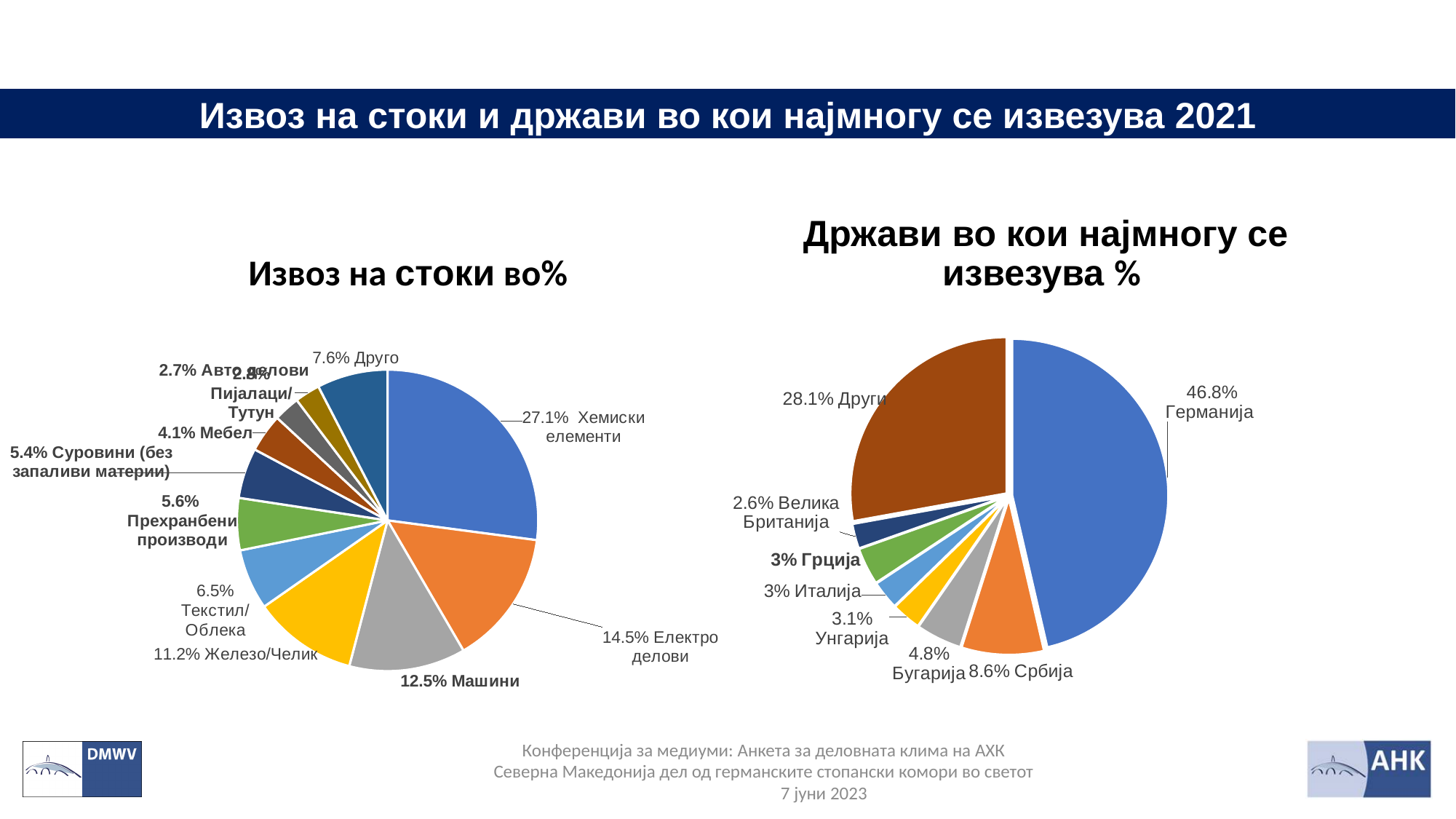
In the chart titled "Извоз на стоки во%", what share is labelled for Друго? 7.6% In the chart titled "Држави во кои најмногу се извезува %", what is the difference between the shares for Србија and Бугарија? 3.8% In the chart titled "Извоз на стоки во%", what is the difference between the shares for Електро делови and Машини? 2% In the chart titled "Извоз на стоки во%", which category has the largest slice? Хемиски елементи In the chart titled "Држави во кои најмногу се извезува %", how many slices does the pie have? 8 In the chart titled "Извоз на стоки во%", which is larger: Текстил/Облека or Прехранбени производи? Текстил/Облека In the chart titled "Држави во кои најмногу се извезува %", what share is labelled for Други? 28.1% In the chart titled "Извоз на стоки во%", what share is labelled for Хемиски елементи? 27.1% What type of chart is used for "Држави во кои најмногу се извезува %"? Pie chart In the chart titled "Извоз на стоки во%", what share is labelled for Железо/Челик? 11.2% In the chart titled "Држави во кои најмногу се извезува %", what share is labelled for Германија? 46.8% In the chart titled "Држави во кои најмногу се извезува %", which country has the smallest slice? Велика Британија